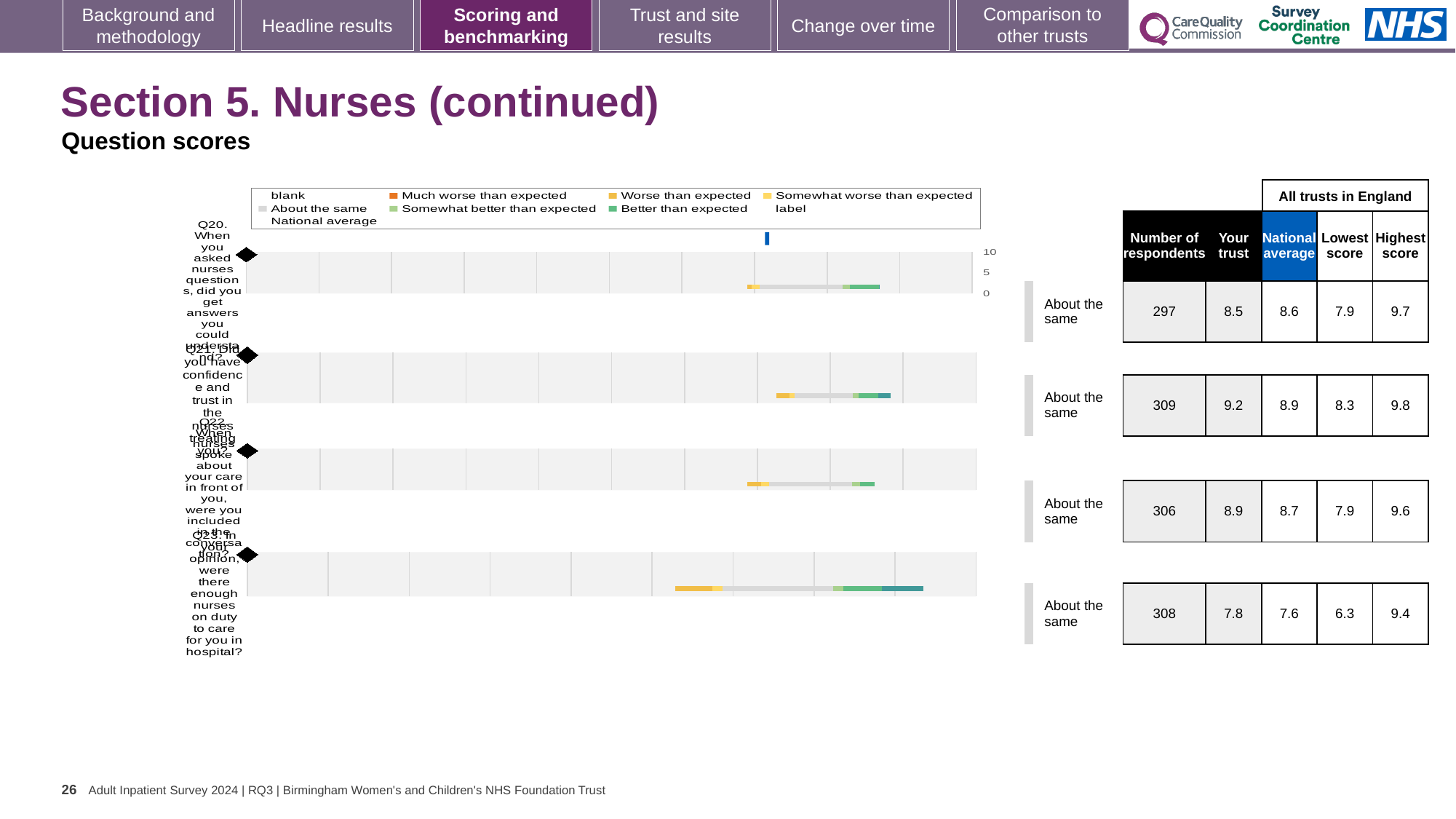
How many questions (Q20 to Q23) have a benchmarking bar chart on this slide? 4 What is the lowest score across all trusts in England shown for Q23? 6.3 Which question has the lowest 'Your trust' score on this slide? Q23 What kind of chart is used to show the question scores for Q20 to Q23? bar chart What is the 'Your trust' score shown for Q21 (confidence and trust in the nurses)? 9.2 For Q21, how much higher is the 'Your trust' score than the national average? 0.3 What benchmark category is shown next to the Q20 chart? About the same What is the highest score across all trusts in England shown for Q21? 9.8 Which question has the highest 'Your trust' score on this slide? Q21 What is the national average shown for Q23 (enough nurses on duty)? 7.6 For Q20, which is larger: the 'Your trust' score or the national average? National average How many respondents are shown for Q22 (nurses speaking about your care in front of you)? 306